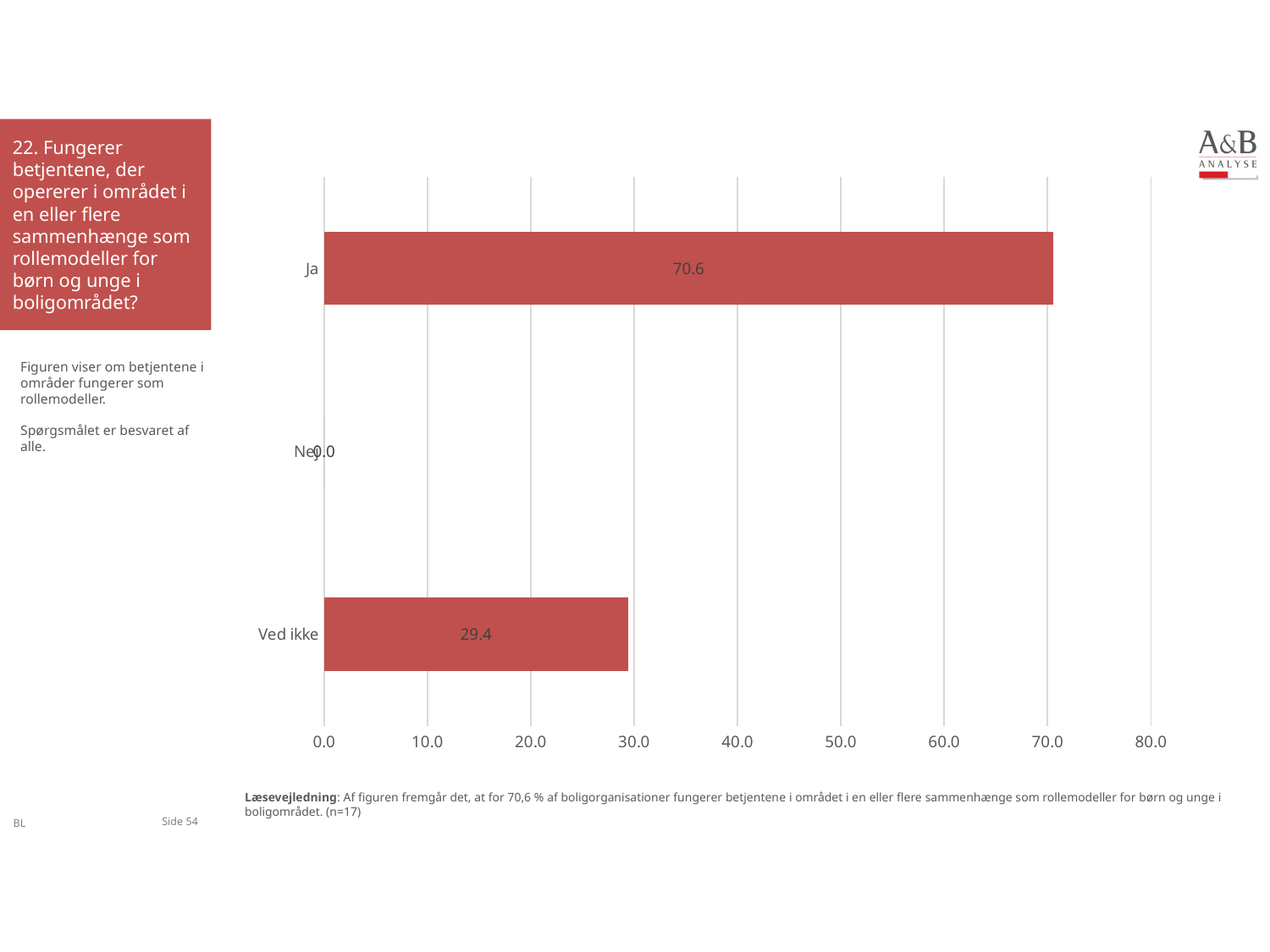
Which category has the lowest value? Nej How many categories are shown in the chart? 3 What is the value for "Ved ikke"? 29.4 What is the value for "Ja"? 70.6 Which is larger, the value for "Ja" or the value for "Ved ikke"? Ja What is the difference between the values for "Ja" and "Ved ikke"? 41.2 Is the value for "Ja" greater or less than 70.0? greater Which category has the highest value? Ja What kind of chart is shown on the slide? bar chart Is the value for "Ved ikke" greater or less than 30.0? less What is the highest value shown on the x axis? 80.0 What is the value for "Nej"? 0.0